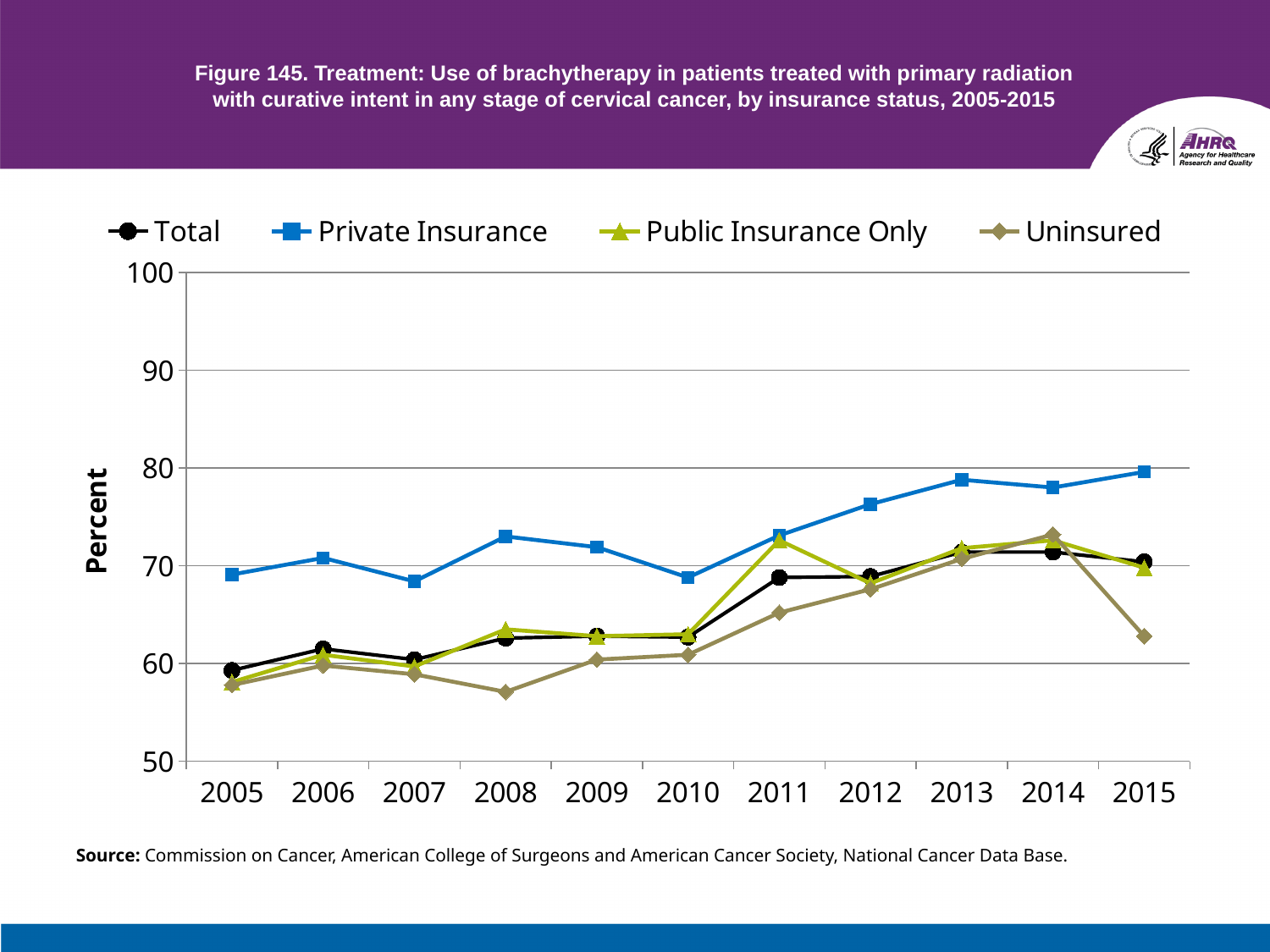
Is the value for Uninsured in 2015 greater or less than 65? less How many years are plotted along the x axis? 11 Which series has the highest value in 2015? Private Insurance Is the value for Uninsured in 2008 greater or less than 60? less What kind of chart is shown on the slide? line chart How many series does the legend list? 4 In 2011, which is larger: Public Insurance Only or Uninsured? Public Insurance Only Is the value for Private Insurance in 2015 greater or less than 70? greater What is the label on the y axis? Percent Does the Private Insurance line rise or fall from 2010 to 2015? rise Which series has the lowest value in 2015? Uninsured